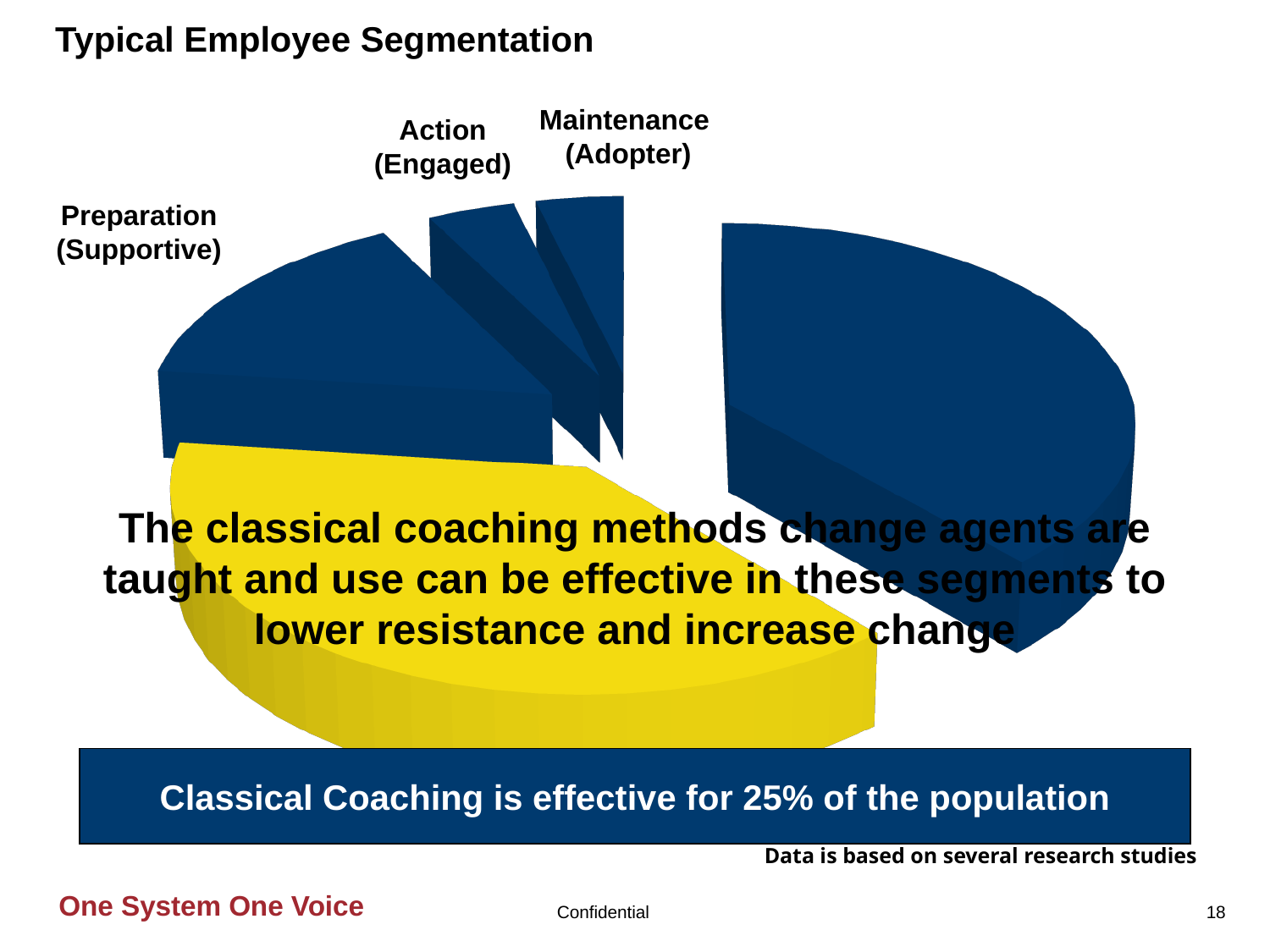
How many slices of the pie chart have a readable label? 3 Which is larger in the pie chart, the Preparation (Supportive) slice or the Maintenance (Adopter) slice? Preparation (Supportive) How many slices does the pie chart have? 5 What is the title of the slide containing the pie chart? Typical Employee Segmentation Among the labeled slices of the pie chart, which is the largest? Preparation (Supportive) What colour is used for the slice that is highlighted differently from the rest of the pie chart? yellow According to the banner below the pie chart, for what share of the population is Classical Coaching effective? 25% Which is larger in the pie chart, the Preparation (Supportive) slice or the Action (Engaged) slice? Preparation (Supportive) What kind of chart is shown on the slide? pie chart